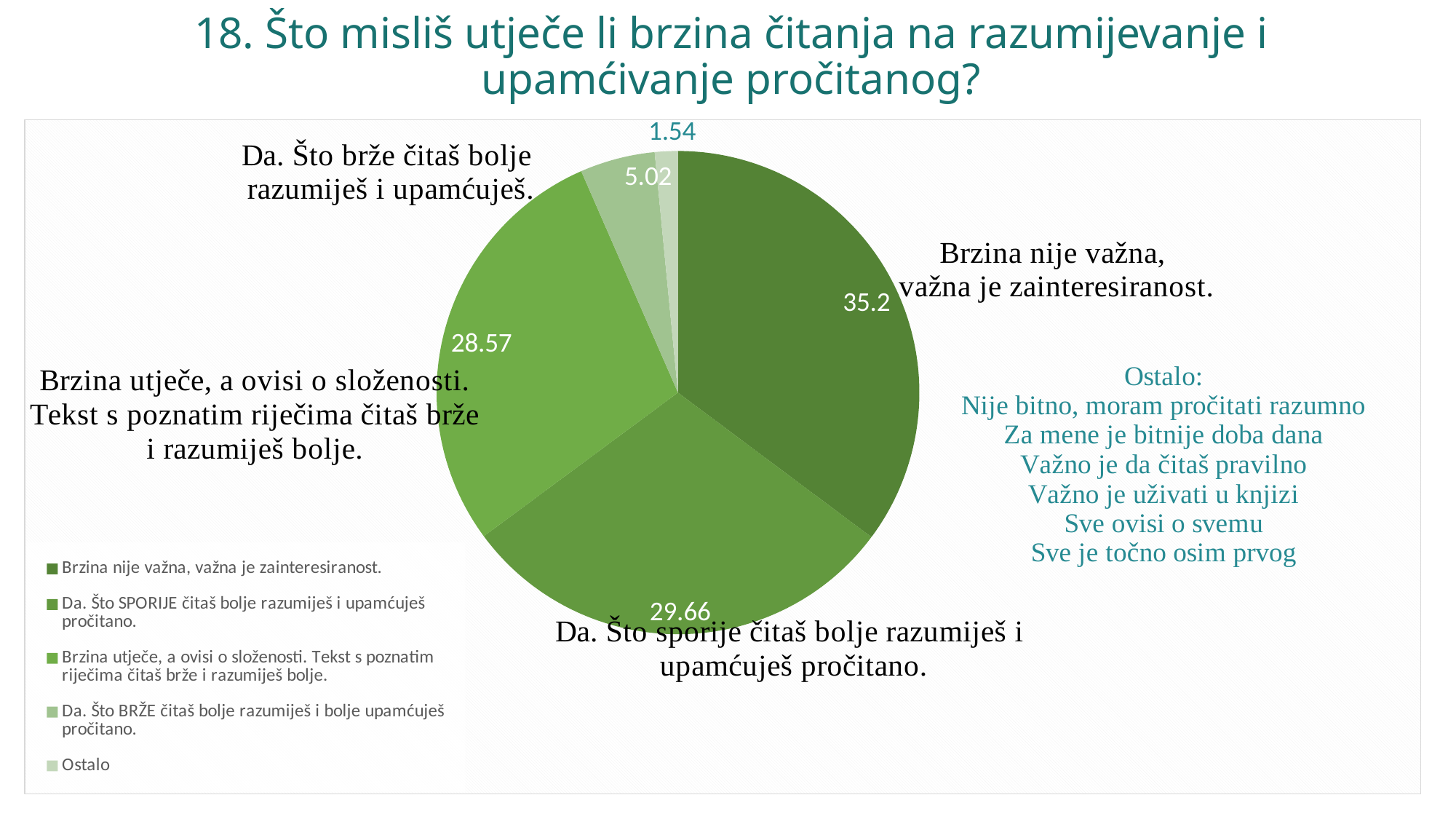
What is the value for the slice "Da. Što SPORIJE čitaš bolje razumiješ i upamćuješ pročitano."? 29.66 Which category has the largest slice of the pie? Brzina nije važna, važna je zainteresiranost. How many slices does the pie chart have? 5 What is the value for the slice "Ostalo"? 1.54 What is the value for the slice "Brzina utječe, a ovisi o složenosti. Tekst s poznatim riječima čitaš brže i razumiješ bolje."? 28.57 What is the difference between the value for "Brzina nije važna, važna je zainteresiranost." and the value for "Da. Što SPORIJE čitaš bolje razumiješ i upamćuješ pročitano."? 5.54 What is the value for the slice "Da. Što BRŽE čitaš bolje razumiješ i bolje upamćuješ pročitano."? 5.02 Which is larger: the value for "Da. Što BRŽE čitaš bolje razumiješ i bolje upamćuješ pročitano." or the value for "Ostalo"? Da. Što BRŽE čitaš bolje razumiješ i bolje upamćuješ pročitano. Which category has the smallest slice of the pie? Ostalo What is the value for the slice "Brzina nije važna, važna je zainteresiranost."? 35.2 What type of chart is shown on the slide? pie chart How many entries does the legend list? 5